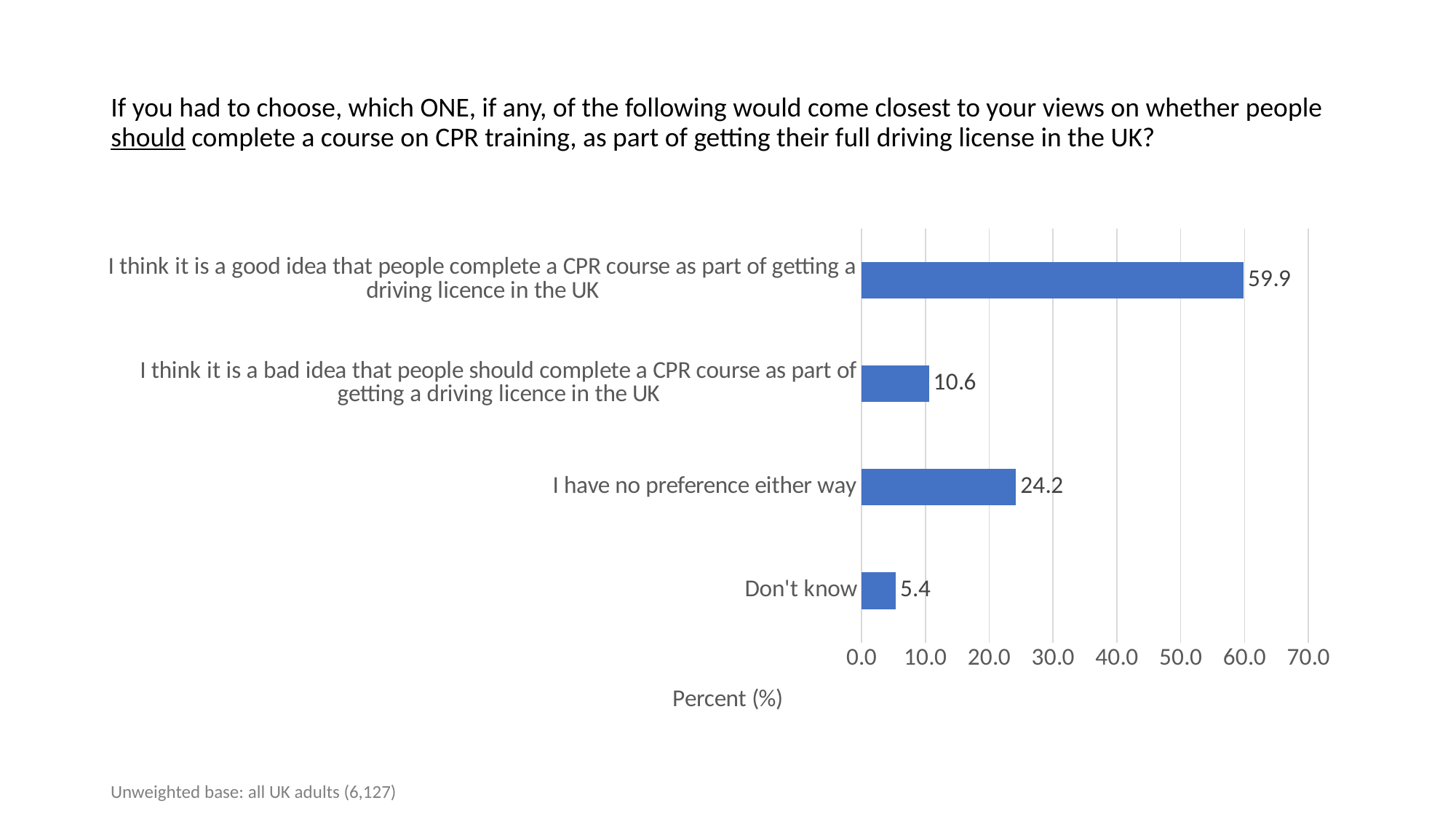
How many categories are shown in the chart? 4 Which category has the highest value? I think it is a good idea that people complete a CPR course as part of getting a driving licence in the UK What is the difference between the value for "I have no preference either way" and the value for "I think it is a bad idea that people should complete a CPR course as part of getting a driving licence in the UK"? 13.6 What is the value for "Don't know"? 5.4 Which category has the lowest value? Don't know What is the value for "I think it is a good idea that people complete a CPR course as part of getting a driving licence in the UK"? 59.9 What kind of chart is shown on the slide? bar chart Which is larger: the value for "I have no preference either way" or the value for "Don't know"? I have no preference either way What is the value for "I have no preference either way"? 24.2 Is the value for "I think it is a good idea that people complete a CPR course as part of getting a driving licence in the UK" greater or less than 50.0? greater What is the value for "I think it is a bad idea that people should complete a CPR course as part of getting a driving licence in the UK"? 10.6 What is the label of the horizontal axis? Percent (%)